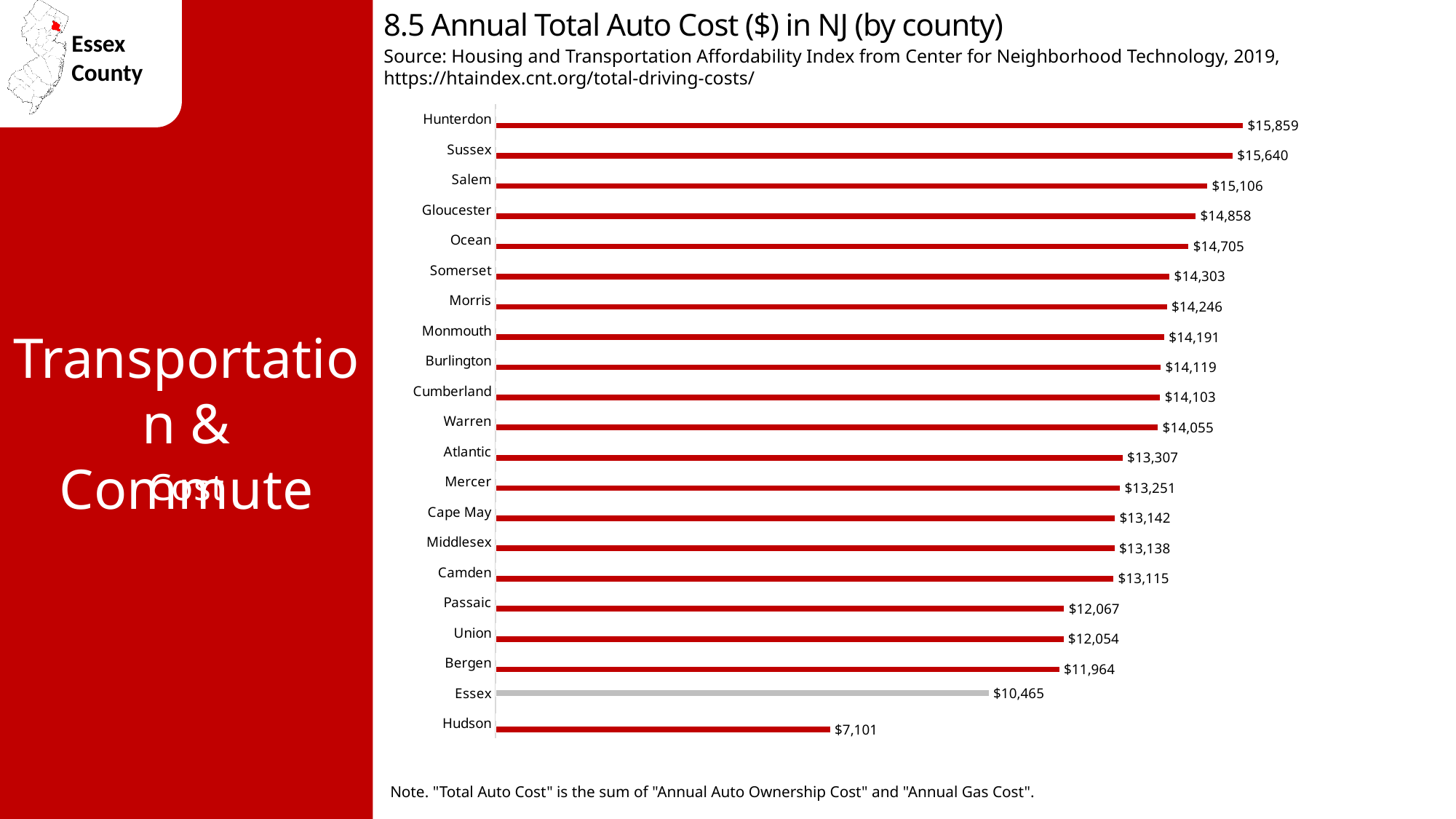
Which county has the highest annual total auto cost? Hunterdon Which county's bar is shown in a different colour (grey) from the others? Essex What is the annual total auto cost for Essex County? $10,465 Which county has a higher annual total auto cost, Sussex or Salem? Sussex What is the difference in annual total auto cost between Essex and Hudson? $3,364 What type of chart is used on this slide? Bar chart What is the annual total auto cost for Hunterdon County? $15,859 What is the difference in annual total auto cost between Hunterdon and Hudson? $8,758 Which county has a higher annual total auto cost, Essex or Bergen? Bergen Which county has the lowest annual total auto cost? Hudson How many counties are shown in the chart? 21 What is the annual total auto cost for Bergen County? $11,964